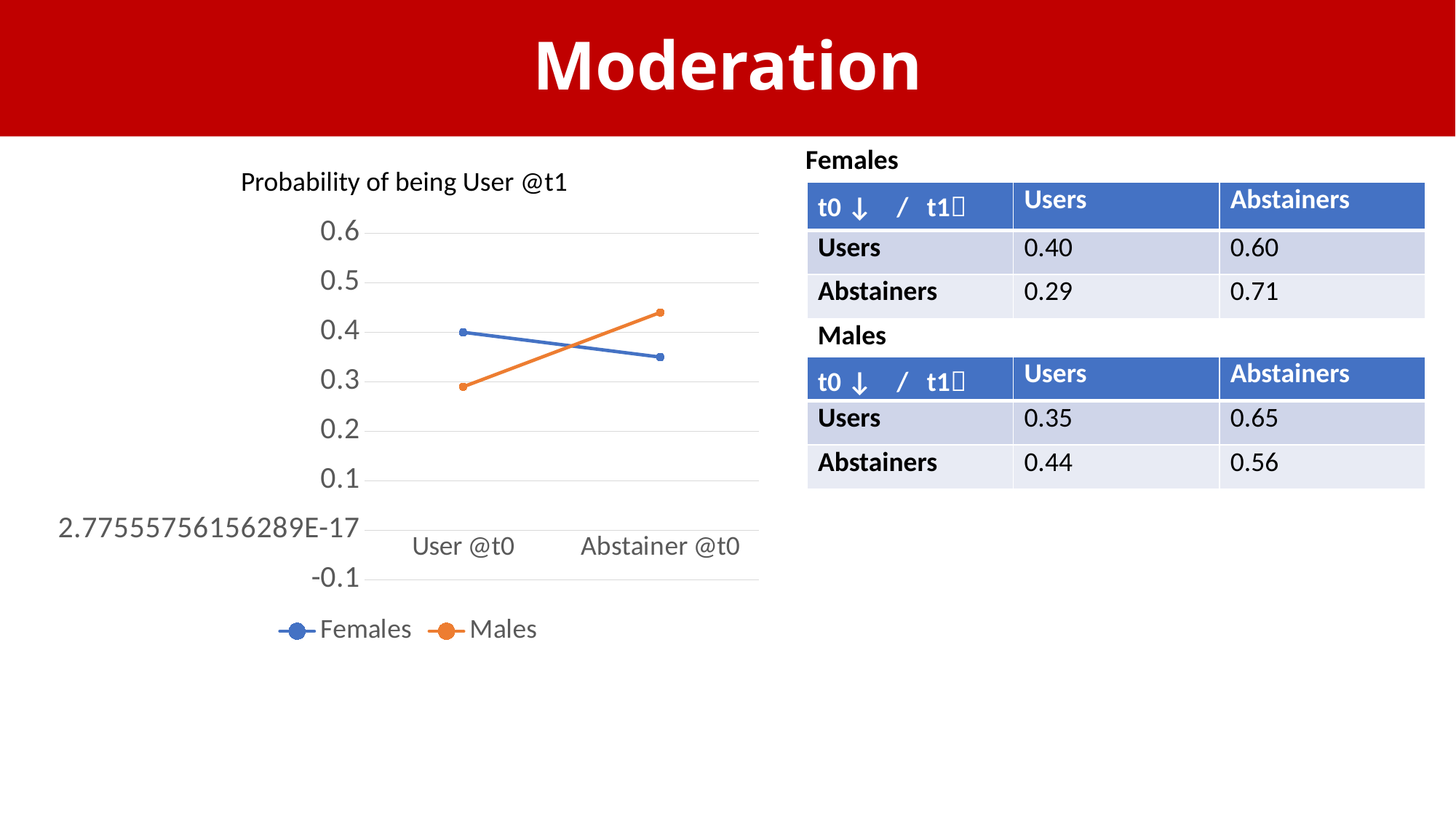
Is the value for Males at Abstainer @t0 greater or less than 0.4? greater Does the Females line rise or fall from User @t0 to Abstainer @t0? fall What is the title of the chart? Probability of being User @t1 What is the value for Females at User @t0? 0.4 Does the Males line rise or fall from User @t0 to Abstainer @t0? rise How many series does the chart's legend list? 2 At Abstainer @t0, which series has the higher value, Females or Males? Males At User @t0, which series has the higher value, Females or Males? Females Is the value for Females at Abstainer @t0 greater or less than 0.4? less What kind of chart is shown on the slide? line chart How many categories are shown on the x axis of the chart? 2